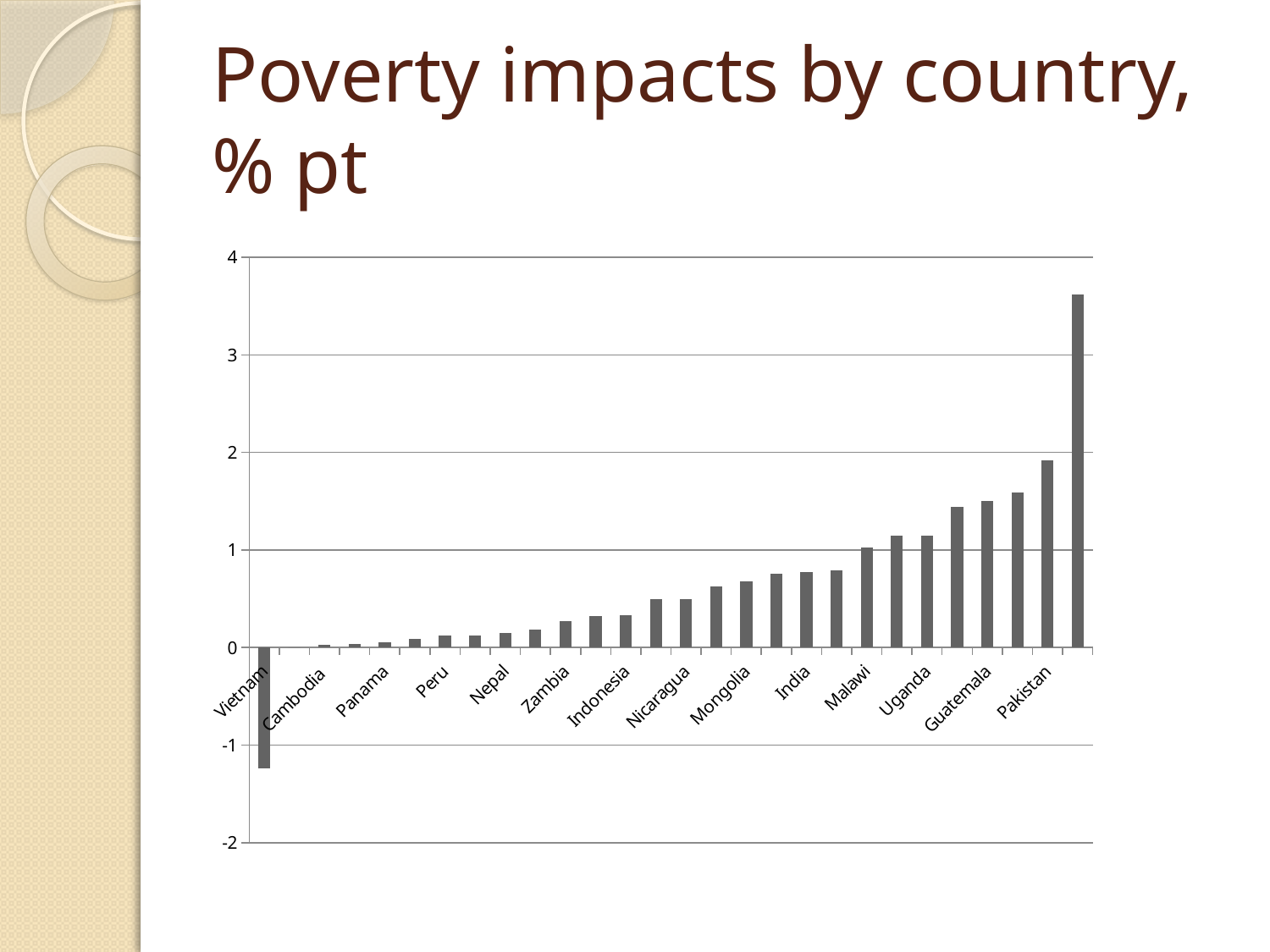
Which labeled country is the only one with a negative value? Vietnam Is the value for Pakistan greater or less than 2? less Is the value for Nicaragua greater or less than 1? less Which has the larger value, Pakistan or Vietnam? Pakistan Is the value for Vietnam greater or less than 0? less Do the values generally rise or fall moving from left to right along the x axis? rise What kind of chart is shown on the slide? bar chart What is the title of the chart? Poverty impacts by country, % pt Which has the larger value, Peru or Guatemala? Guatemala